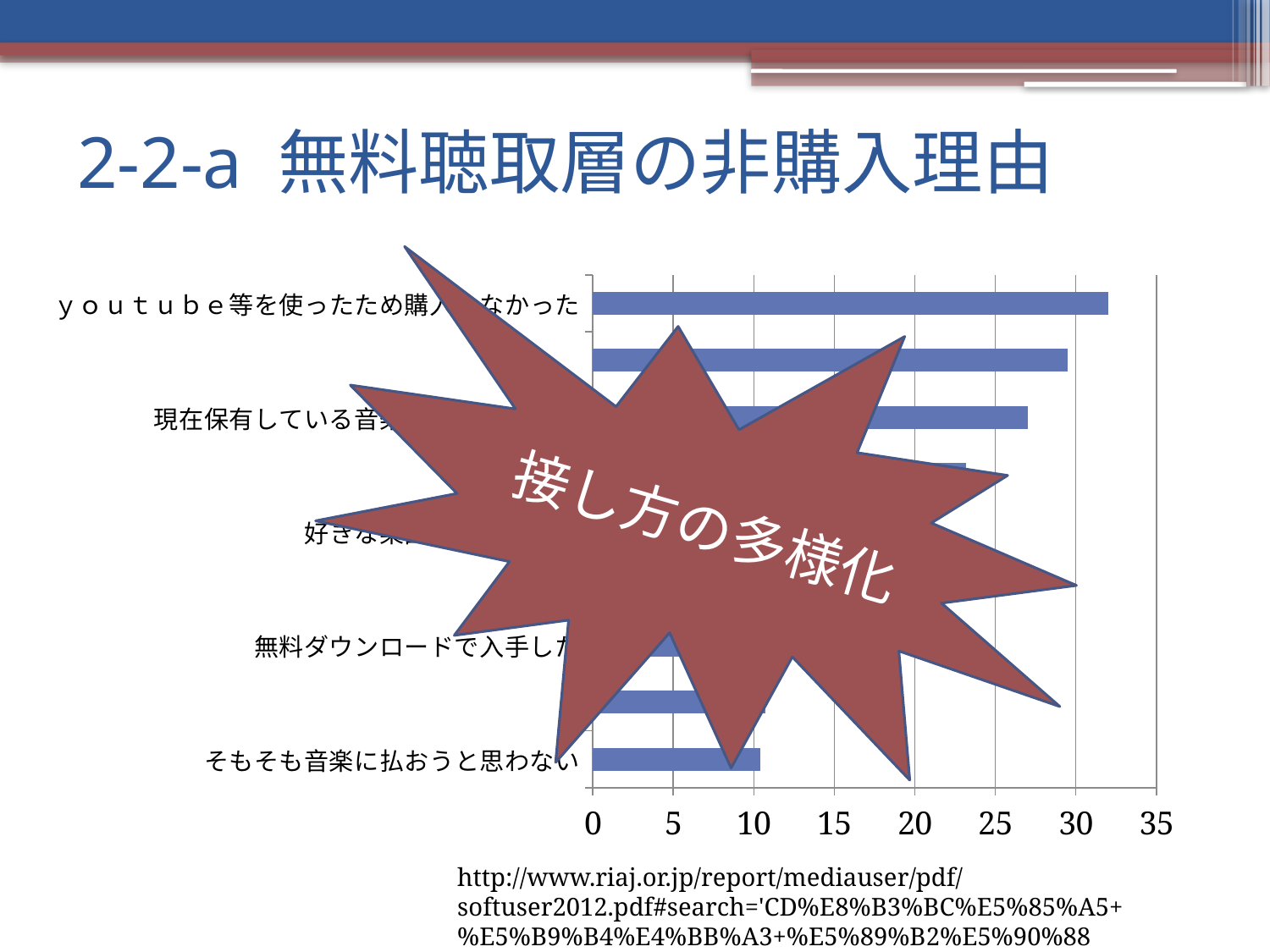
Is the value for ｙｏｕｔｕｂｅ等を使ったため購入しなかった greater or less than 30? greater What is the maximum value shown on the horizontal axis of the chart? 35 Is the value for そもそも音楽に払おうと思わない greater or less than 15? less What is the title of the slide containing the chart? 2-2-a 無料聴取層の非購入理由 Which has a larger value: ｙｏｕｔｕｂｅ等を使ったため購入しなかった or そもそも音楽に払おうと思わない? ｙｏｕｔｕｂｅ等を使ったため購入しなかった What kind of chart is shown on the slide? bar chart Is the value for 現在保有している音楽 (the third bar from the top) greater or less than 25? greater Which category has the longest bar in the chart? ｙｏｕｔｕｂｅ等を使ったため購入しなかった What text is written in the red starburst shape overlaid on the chart? 接し方の多様化